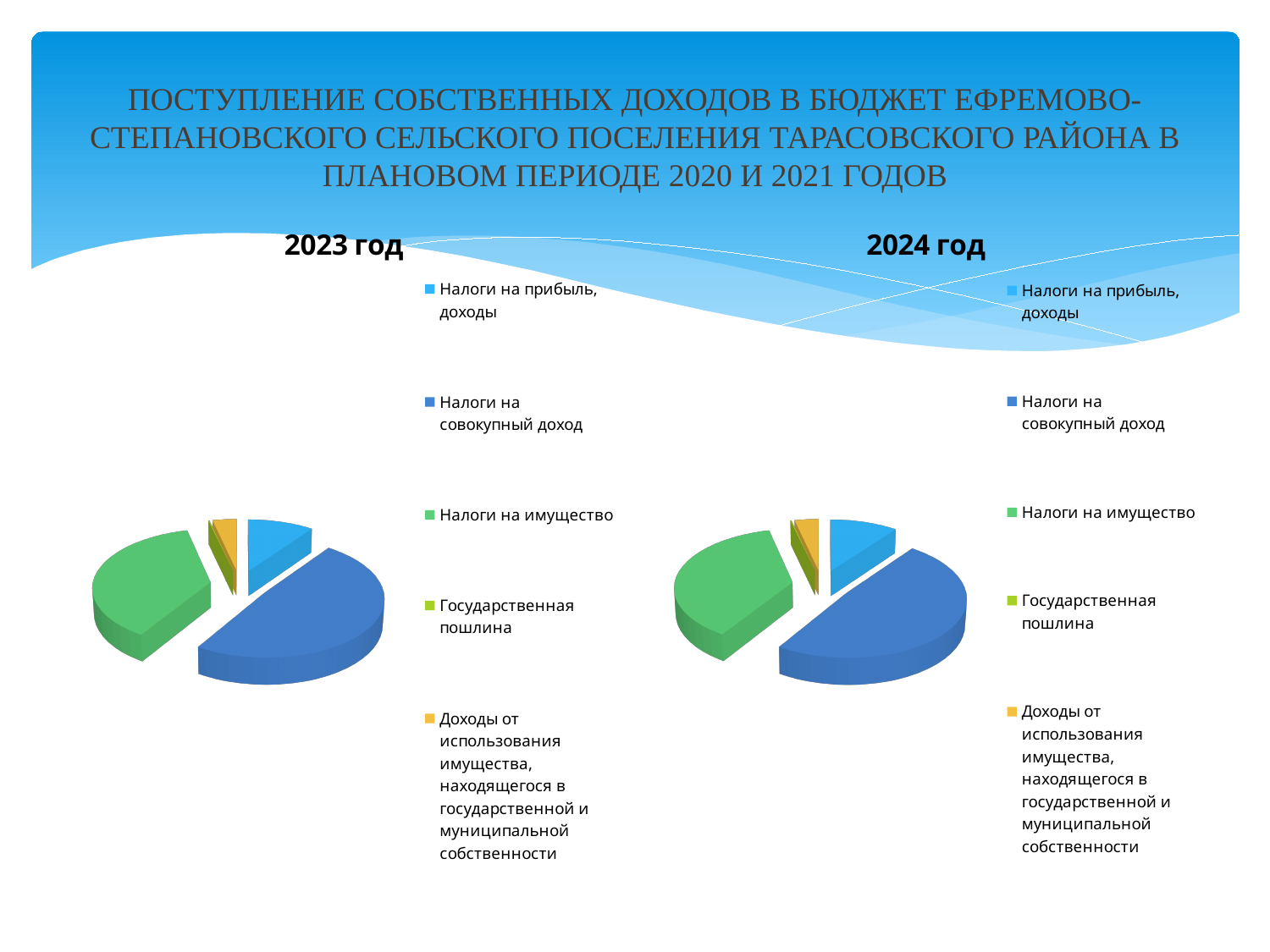
In the "2024 год" chart, how many slices does the pie have? 5 In the "2023 год" chart, which category has the largest slice? Налоги на совокупный доход In the "2024 год" chart, which category has the largest slice? Налоги на совокупный доход In the "2024 год" chart, which slice is larger: "Налоги на совокупный доход" or "Налоги на имущество"? Налоги на совокупный доход What kind of chart is the "2024 год" chart? Pie chart In the "2023 год" chart, which category is shown in green? Налоги на имущество What kind of chart is the "2023 год" chart? Pie chart In the "2024 год" chart, which category is shown in orange? Доходы от использования имущества, находящегося в государственной и муниципальной собственности In the "2024 год" chart, which slice is larger: "Налоги на прибыль, доходы" or "Государственная пошлина"? Налоги на прибыль, доходы In the "2023 год" chart, how many categories does the legend list? 5 In the "2023 год" chart, which slice is larger: "Налоги на имущество" or "Налоги на прибыль, доходы"? Налоги на имущество